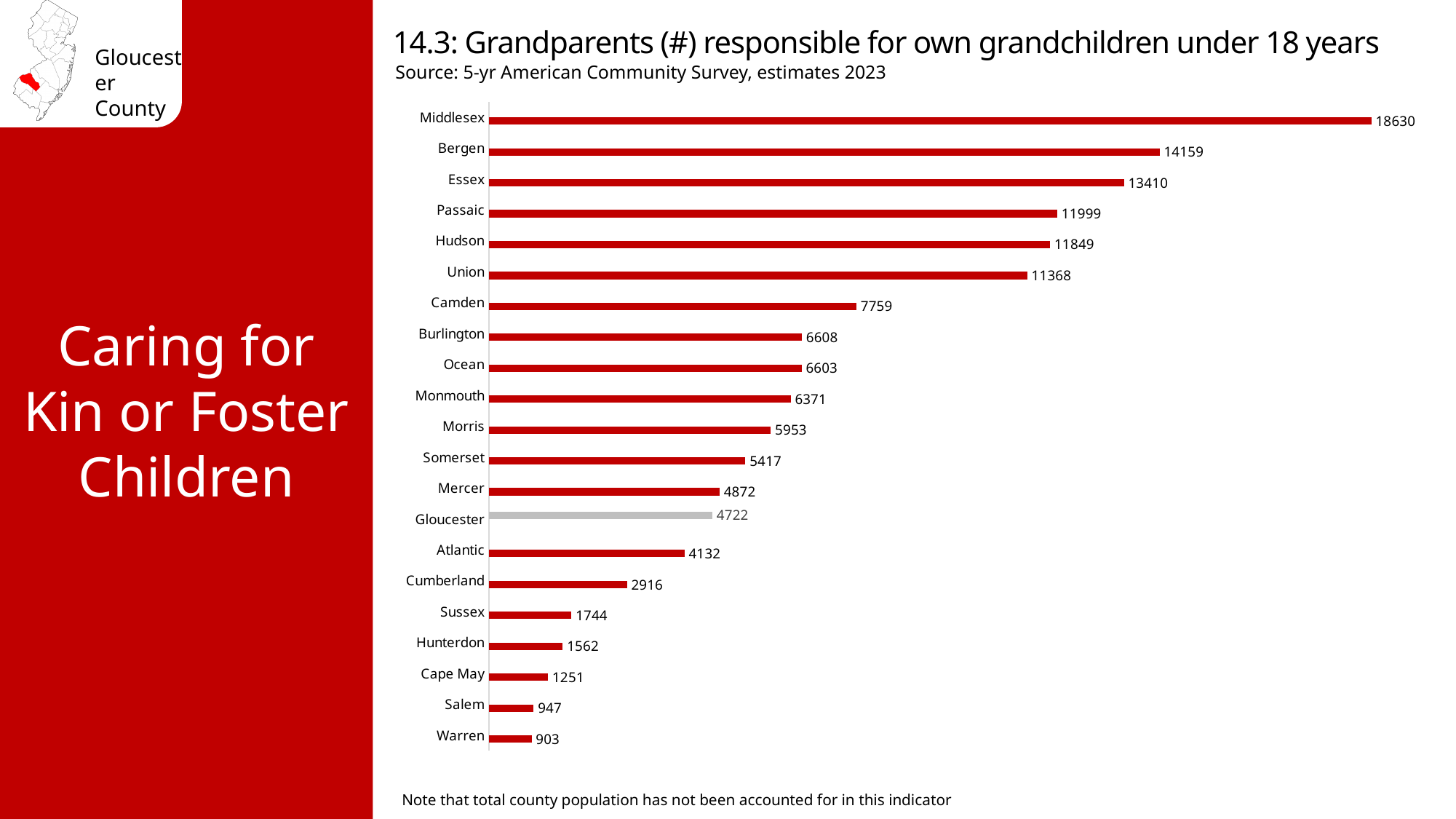
What is the difference between the values for Mercer and Gloucester? 150 Which has a larger value, Sussex or Hunterdon? Sussex Which county's bar is shown in grey rather than red? Gloucester What is the value shown for Cape May? 1251 Which county has the lowest value on the chart? Warren What is the difference between the values for Middlesex and Bergen? 4471 What is the number of grandparents responsible for own grandchildren in Gloucester County? 4722 What type of chart is shown on the slide? Bar chart Which county has the highest number of grandparents responsible for own grandchildren? Middlesex Which has a larger value, Passaic or Hudson? Passaic What is the value shown for Camden? 7759 How many counties are shown on the chart? 21